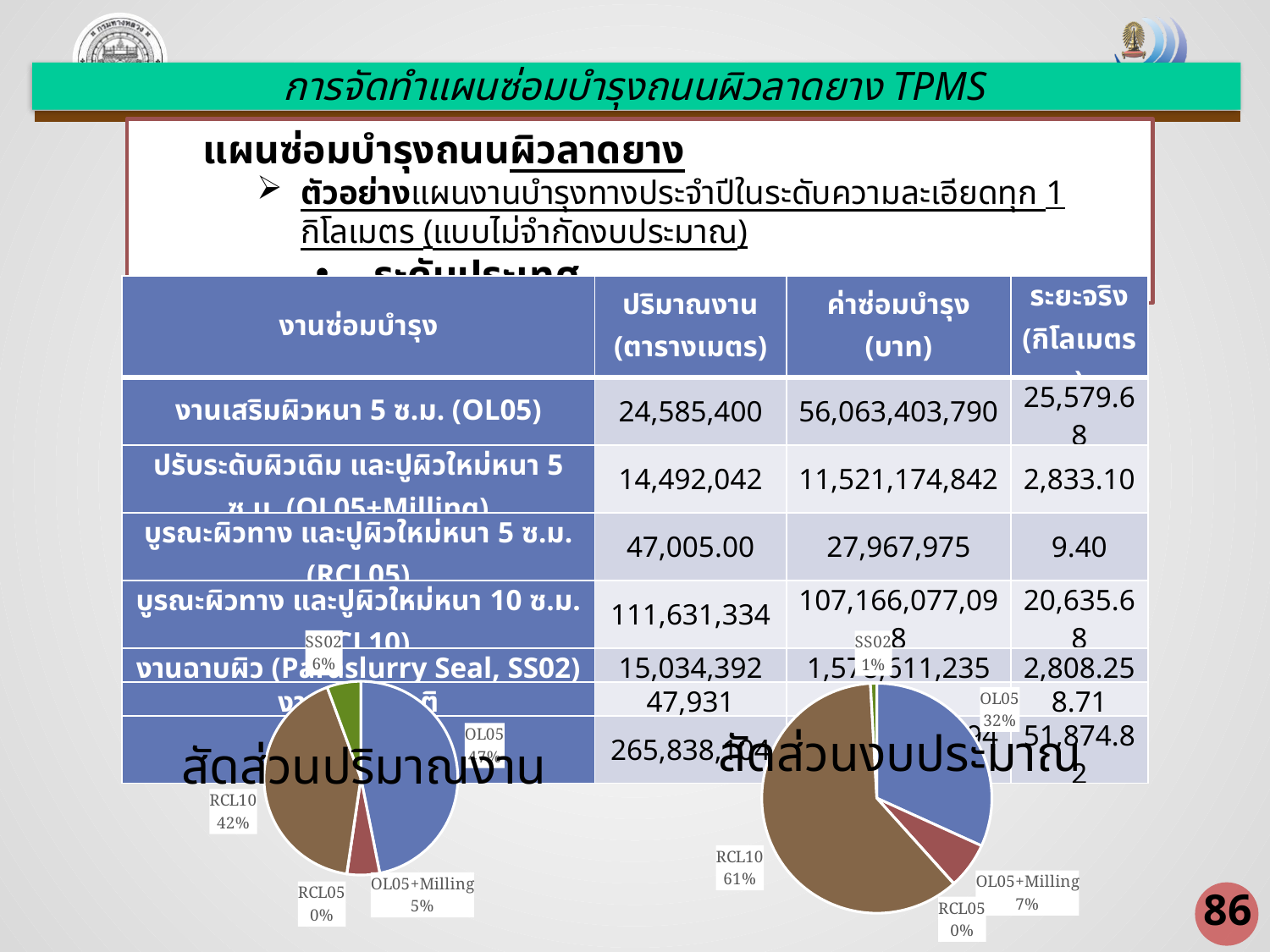
In the right pie chart (สัดส่วนงบประมาณ), what share is shown for RCL10? 61% In the left pie chart (สัดส่วนปริมาณงาน), what share is shown for RCL10? 42% In the right pie chart (สัดส่วนงบประมาณ), which category has the largest share? RCL10 In the right pie chart (สัดส่วนงบประมาณ), what is the difference between the shares of RCL10 and OL05? 29% In the left pie chart (สัดส่วนปริมาณงาน), what share is shown for RCL05? 0% In the left pie chart (สัดส่วนปริมาณงาน), which has the larger share, SS02 or OL05+Milling? SS02 In the right pie chart (สัดส่วนงบประมาณ), what share is shown for OL05? 32% In the right pie chart (สัดส่วนงบประมาณ), what share is shown for SS02? 1% In the left pie chart (สัดส่วนปริมาณงาน), what share is shown for OL05+Milling? 5% What kind of chart is the chart titled สัดส่วนงบประมาณ? Pie chart In the left pie chart (สัดส่วนปริมาณงาน), what share is shown for SS02? 6% In the right pie chart (สัดส่วนงบประมาณ), what share is shown for OL05+Milling? 7%